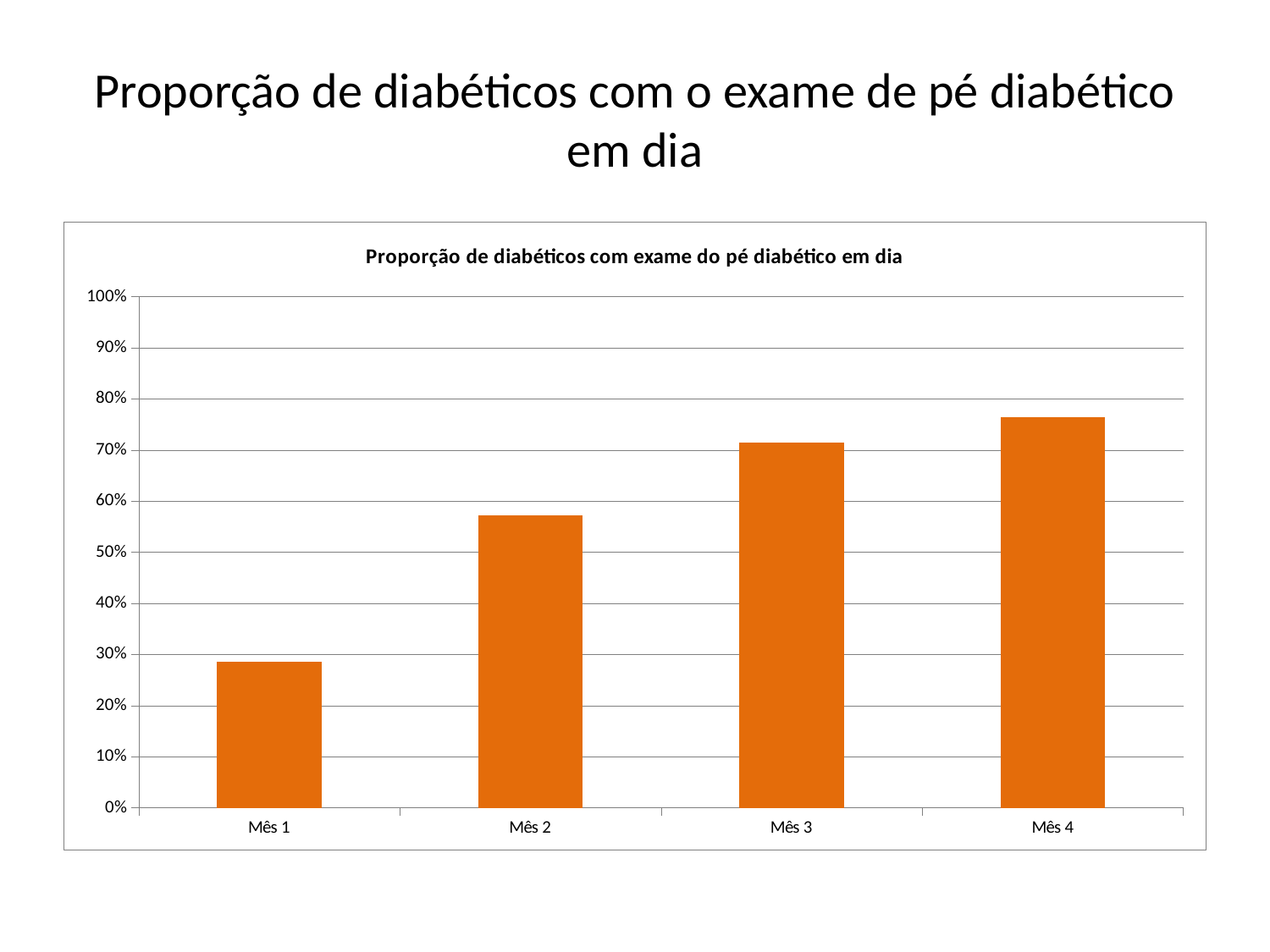
Which is larger, the value for Mês 2 or the value for Mês 3? Mês 3 Is the value for Mês 1 greater or less than 30%? less Is the value for Mês 3 greater or less than 70%? greater How many months (categories) are plotted on the chart? 4 Which month has the lowest proportion of diabetics with the foot exam up to date? Mês 1 Do the values rise or fall from Mês 1 to Mês 4? rise Is the value for Mês 2 greater or less than 50%? greater What is the highest value shown on the vertical axis? 100% What kind of chart is shown on the slide? bar chart What is the title printed inside the chart area? Proporção de diabéticos com exame do pé diabético em dia Which month has the highest proportion of diabetics with the foot exam up to date? Mês 4